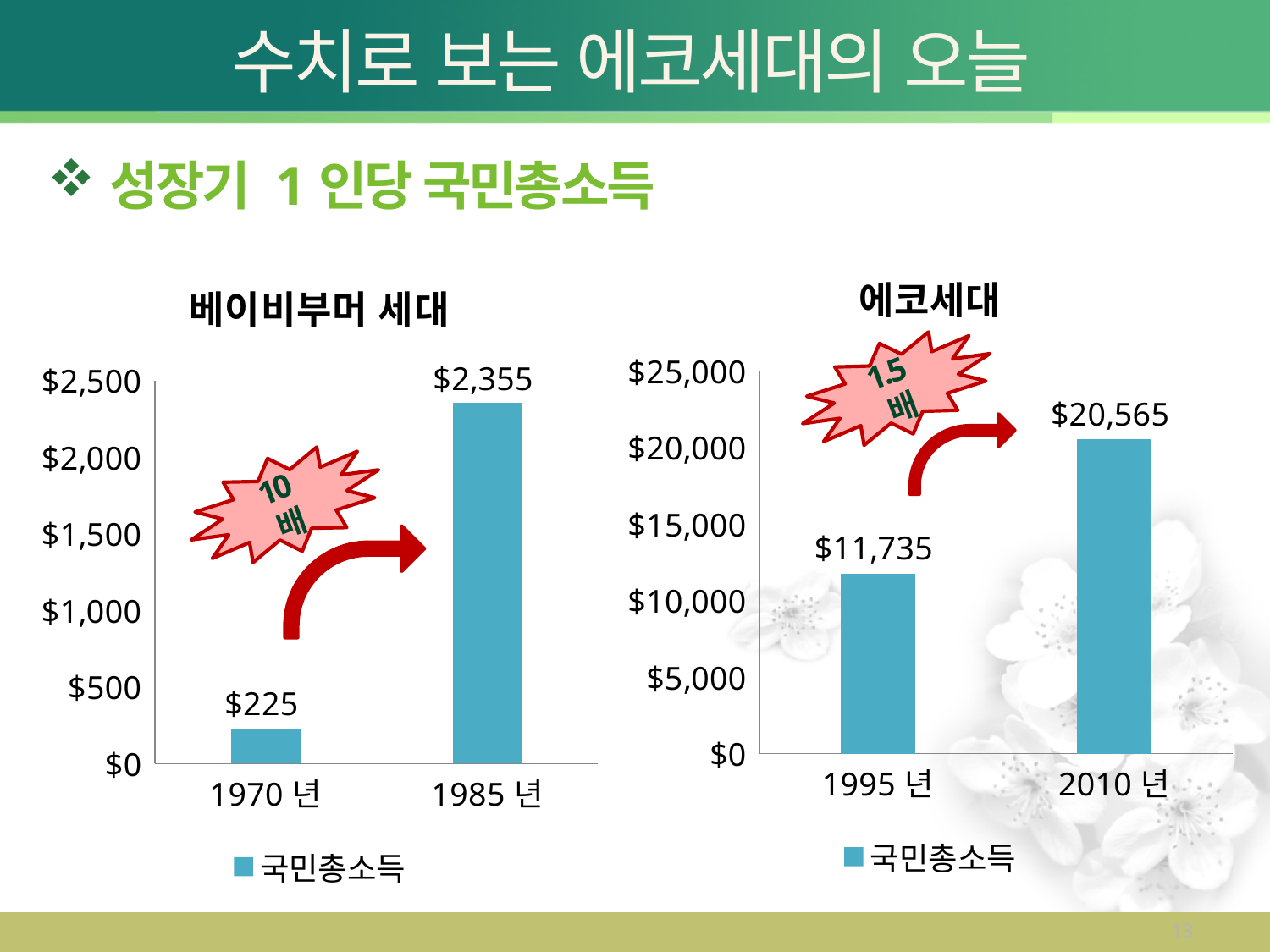
What series name does the legend of the 베이비부머 세대 chart show? 국민총소득 In the 베이비부머 세대 chart, what is the value for 1985 년? $2,355 In the 에코세대 chart, which year has the higher value, 1995 년 or 2010 년? 2010 년 In the 에코세대 chart, what is the value for 1995 년? $11,735 In the 에코세대 chart, what is the difference between the 2010 년 and 1995 년 values? $8,830 In the 에코세대 chart, is the value for 1995 년 greater or less than $10,000? greater In the 에코세대 chart, what is the value for 2010 년? $20,565 In the 베이비부머 세대 chart, what is the difference between the 1985 년 and 1970 년 values? $2,130 In the 베이비부머 세대 chart, which category has the lowest value? 1970 년 How many categories are shown in the 베이비부머 세대 chart? 2 In the 베이비부머 세대 chart, what is the value for 1970 년? $225 What kind of chart is the 에코세대 chart? bar chart